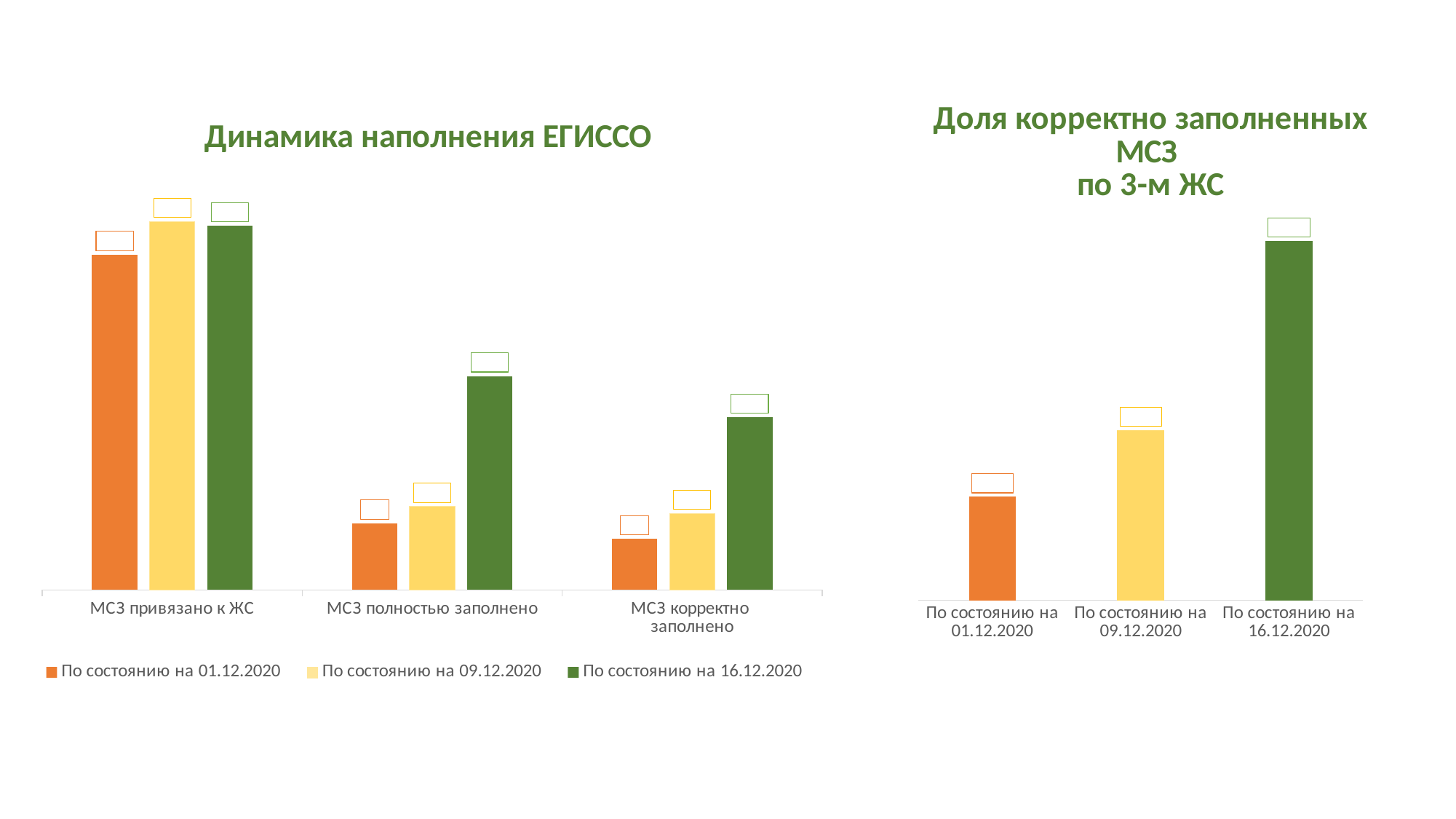
In the 'Динамика наполнения ЕГИССО' chart, which colour represents the series 'По состоянию на 09.12.2020'? yellow In the 'Доля корректно заполненных МСЗ по 3-м ЖС' chart, which date has the lowest bar? По состоянию на 01.12.2020 In the 'Доля корректно заполненных МСЗ по 3-м ЖС' chart, do the values rise or fall from 01.12.2020 to 16.12.2020? rise What kind of chart is the 'Доля корректно заполненных МСЗ по 3-м ЖС' chart on the right? bar chart How many series does the legend of the 'Динамика наполнения ЕГИССО' chart list? 3 How many bars are shown in the 'Доля корректно заполненных МСЗ по 3-м ЖС' chart? 3 In the 'Динамика наполнения ЕГИССО' chart, which category has the highest bars overall? МСЗ привязано к ЖС In the 'Динамика наполнения ЕГИССО' chart, for 'МСЗ полностью заполнено', which series has the tallest bar? По состоянию на 16.12.2020 In the 'Доля корректно заполненных МСЗ по 3-м ЖС' chart, which date has the highest bar? По состоянию на 16.12.2020 How many categories are shown on the x axis of the 'Динамика наполнения ЕГИССО' chart? 3 What kind of chart is the 'Динамика наполнения ЕГИССО' chart on the left? bar chart In the 'Динамика наполнения ЕГИССО' chart, for 'МСЗ корректно заполнено', is the bar for 01.12.2020 or for 16.12.2020 larger? По состоянию на 16.12.2020